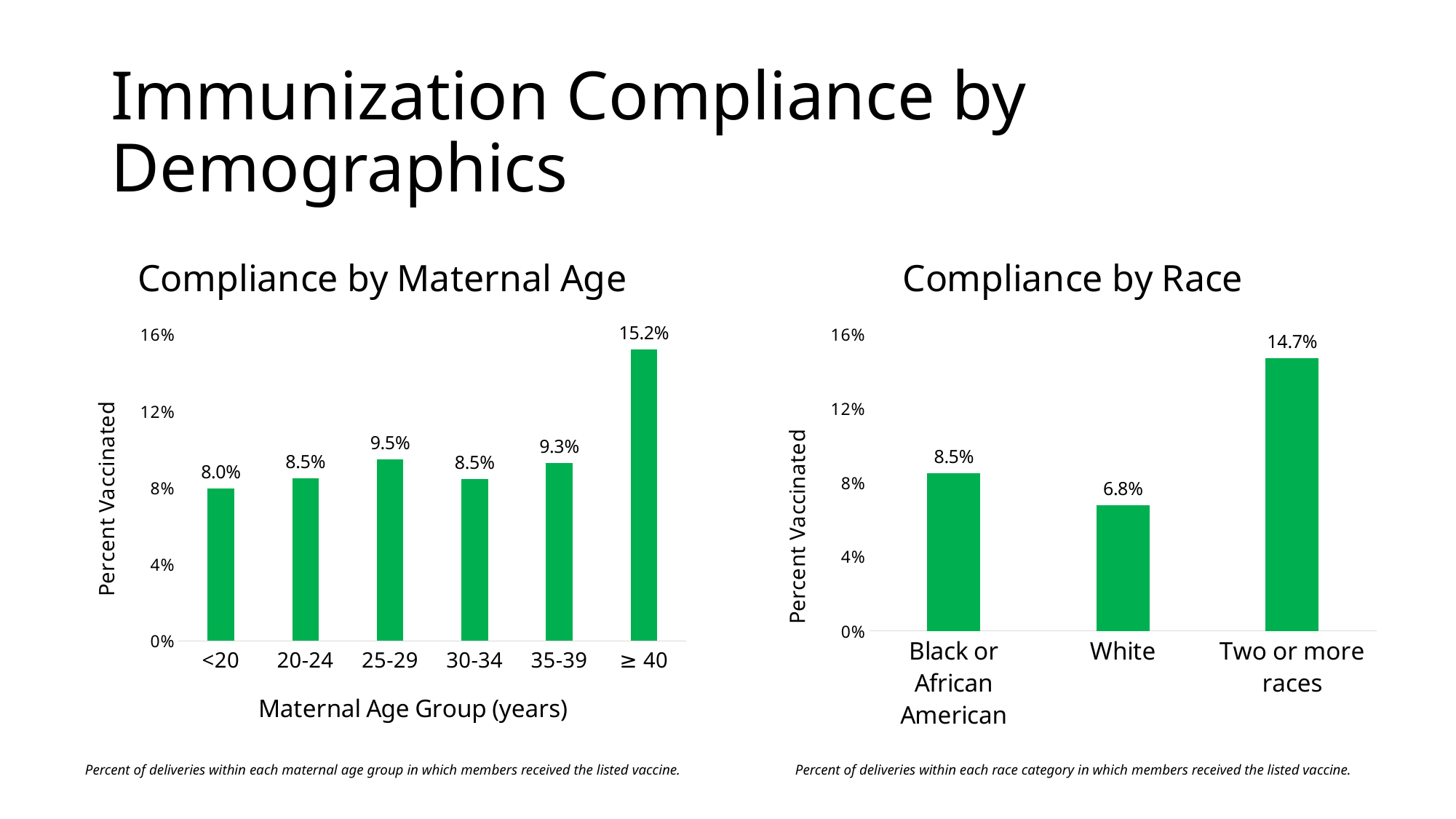
In the 'Compliance by Maternal Age' chart, is the value for the 35-39 group greater or less than 8%? greater In the 'Compliance by Maternal Age' chart, how many maternal age groups are shown? 6 In the 'Compliance by Race' chart, how many race categories are shown? 3 In the 'Compliance by Maternal Age' chart, what is the percent vaccinated for the 25-29 age group? 9.5% In the 'Compliance by Race' chart, which race category has the highest percent vaccinated? Two or more races What kind of chart is the 'Compliance by Race' chart? Bar chart In the 'Compliance by Race' chart, what is the difference in percent vaccinated between Black or African American and White? 1.7% In the 'Compliance by Maternal Age' chart, what is the difference in percent vaccinated between the ≥ 40 group and the <20 group? 7.2% In the 'Compliance by Race' chart, which race category has the lowest percent vaccinated? White In the 'Compliance by Maternal Age' chart, which maternal age group has the highest percent vaccinated? ≥ 40 In the 'Compliance by Maternal Age' chart, which maternal age group has the lowest percent vaccinated? <20 In the 'Compliance by Race' chart, what is the percent vaccinated for White? 6.8%